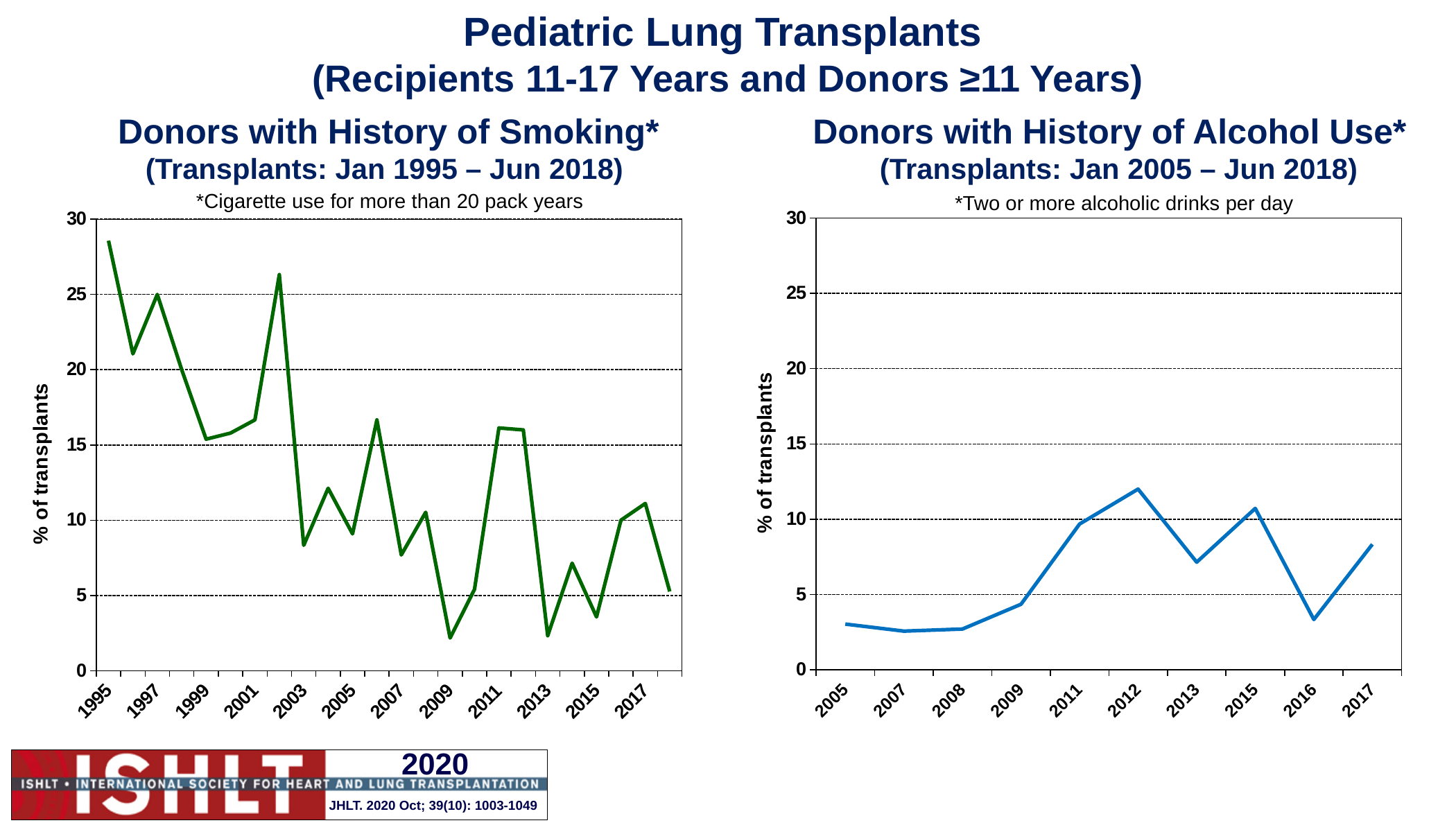
What kind of chart is the 'Donors with History of Smoking*' chart? line chart In the 'Donors with History of Alcohol Use*' chart, is the value for 2012 greater or less than 10? greater In the 'Donors with History of Smoking*' chart, is the value for 2011 greater or less than 15? greater In the 'Donors with History of Alcohol Use*' chart, which year has the highest value? 2012 In the 'Donors with History of Smoking*' chart, is the value for 1995 larger or smaller than the value for 2017? larger In the 'Donors with History of Smoking*' chart, which year has the highest value? 1995 In the 'Donors with History of Smoking*' chart, is the value for 2009 greater or less than 5? less What is the y-axis label of the 'Donors with History of Alcohol Use*' chart? % of transplants In the 'Donors with History of Alcohol Use*' chart, do the values rise or fall from 2005 to 2012? rise How many year labels are shown on the x axis of the 'Donors with History of Alcohol Use*' chart? 10